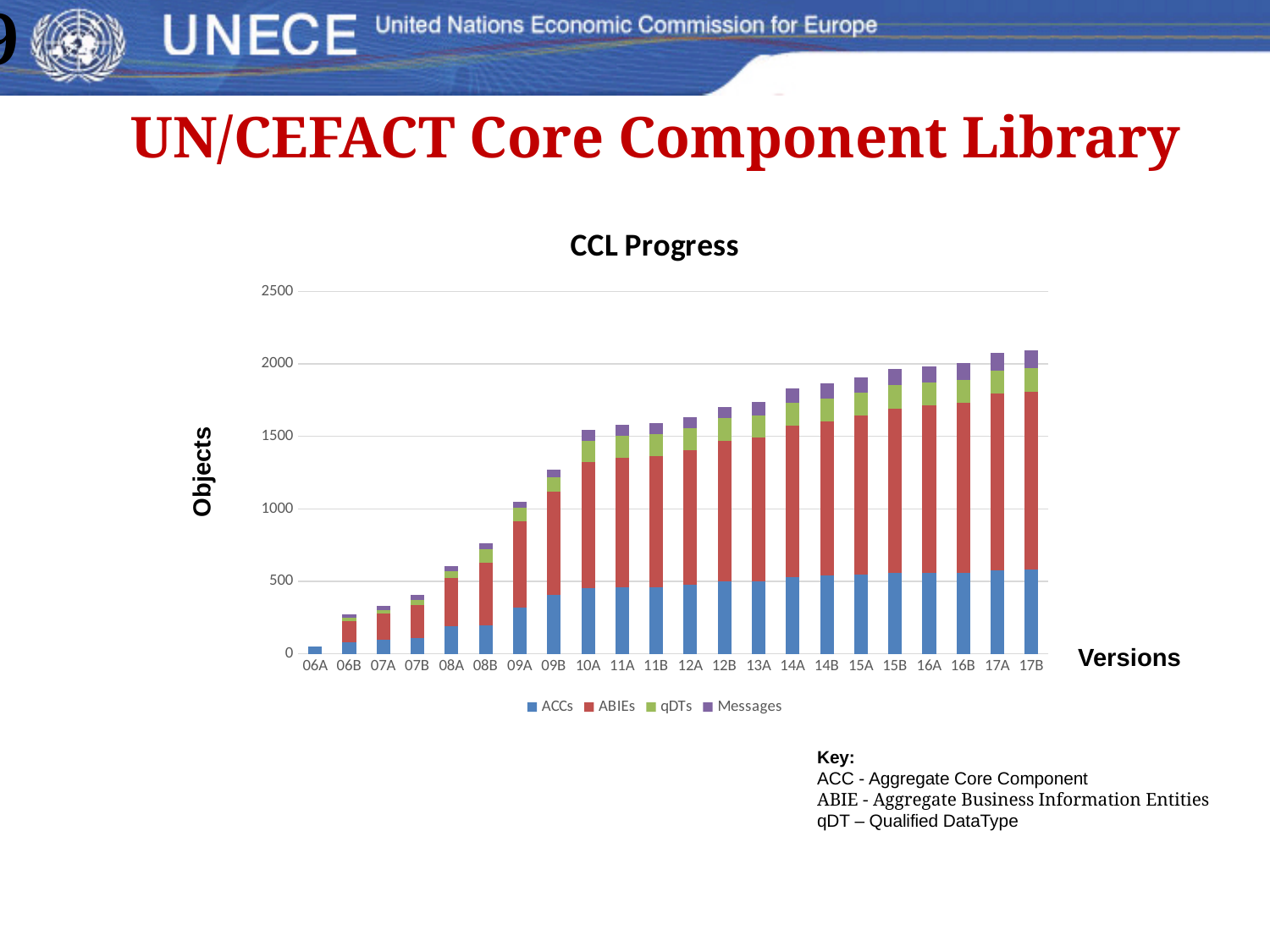
Which version has the highest total number of objects? 17B What is the title of the chart? CCL Progress How many series does the legend list? 4 Is the total for 06A greater or less than 500? less Which has a larger total, 10A or 14A? 14A Is the total for 17B greater or less than 2000? greater Which version has the lowest total number of objects? 06A How many versions are shown along the x axis? 22 Do the total objects rise or fall from 06A to 17B? Rise Which series are listed in the legend? ACCs, ABIEs, qDTs, Messages Is the total for 13A greater or less than 1500? greater What type of chart is shown on the slide? Stacked bar chart